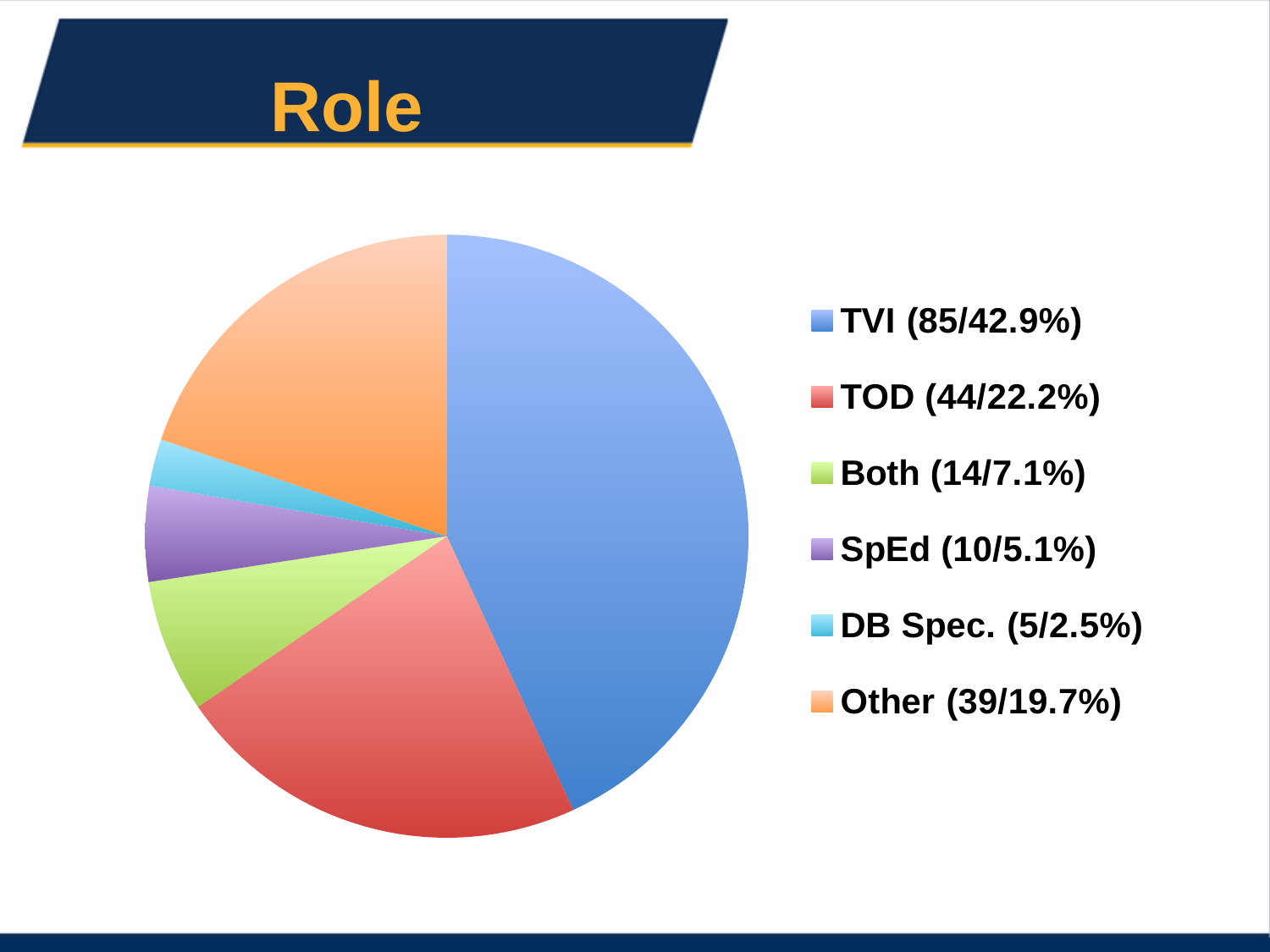
What colour is the slice for Other? orange What is the title of the slide containing the pie chart? Role Which is larger, the count for Both or the count for SpEd? Both What count is shown for DB Spec. in the legend? 5 What is the difference in count between TVI and TOD? 41 What percentage share is shown for Other? 19.7% What percentage share is shown for TOD? 22.2% Which role has the largest slice of the pie? TVI What kind of chart is shown on the slide? pie chart What count is shown for TVI in the legend? 85 Which role has the smallest slice of the pie? DB Spec. How many slices does the pie chart have? 6